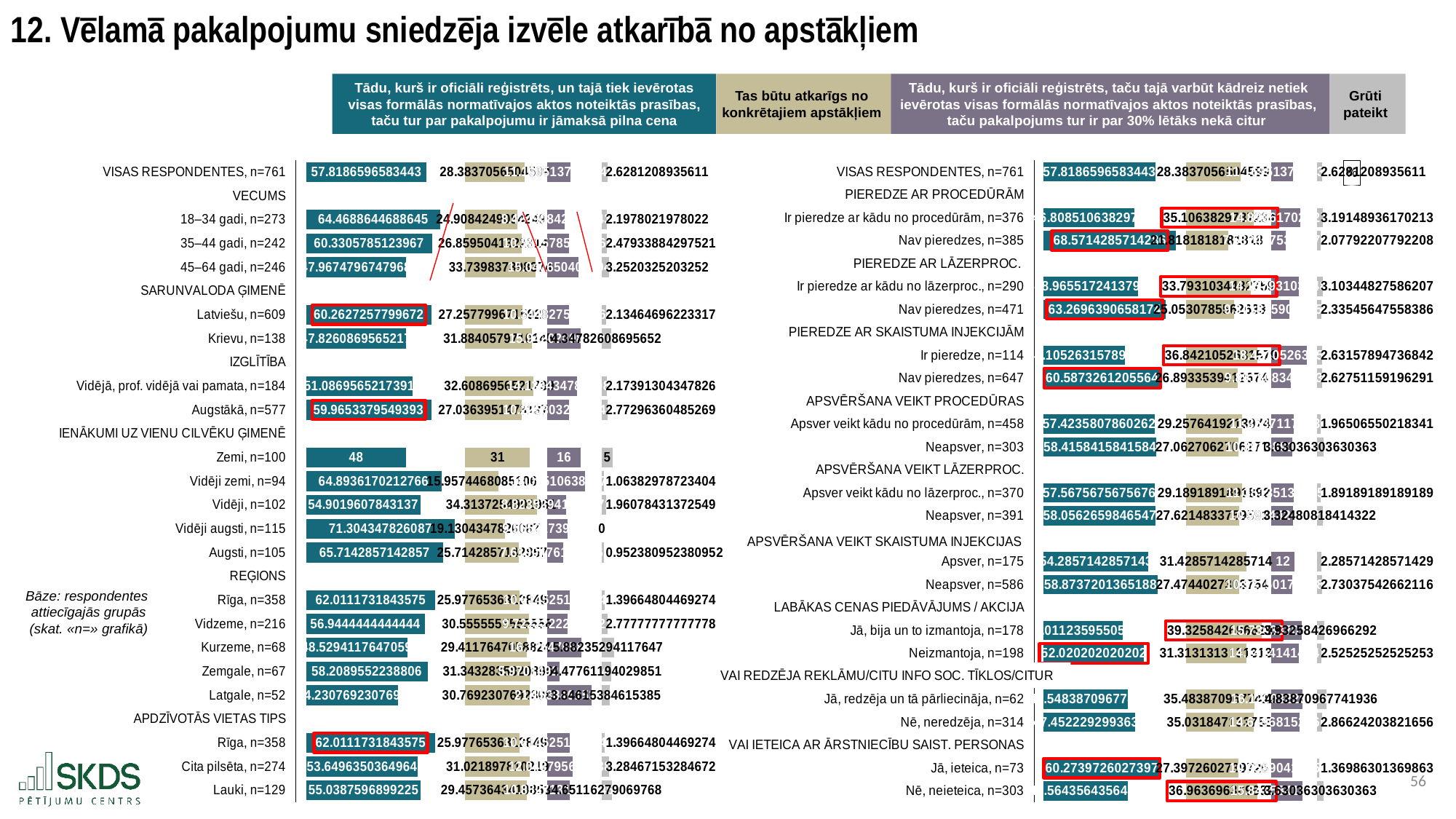
In the left chart, which has the larger first-series value: 'Rīga, n=358' or 'Vidzeme, n=216'? Rīga, n=358 How many answer categories (series) does the legend at the top of the slide list? 4 In the left chart, what is the total of the stacked bar for 'Zemi, n=100'? 100 In the left chart, which income group has the highest value in the first series (officially registered, full price)? Vidēji augsti, n=115 In the left chart, which income group has the lowest value in the first series (officially registered, full price)? Zemi, n=100 In the left chart, what is the 'Grūti pateikt' value for 'Vidēji augsti, n=115'? 0 In the left chart, what is the difference between the first and second series values for 'Zemi, n=100'? 17 In the left chart, what is the value for 'Zemi, n=100' in the first series (officially registered, full price)? 48 In the right chart, what is the 'Grūti pateikt' value for 'Jā, ieteica, n=73'? 1.36986301369863 What kind of chart is used on this slide? bar chart In the right chart, what is the first-series value for 'Nav pieredzes, n=385' under 'Pieredze ar procedūrām'? 68.5714285714286 In the left chart, what is the 'Grūti pateikt' value for 'Augsti, n=105'? 0.952380952380952